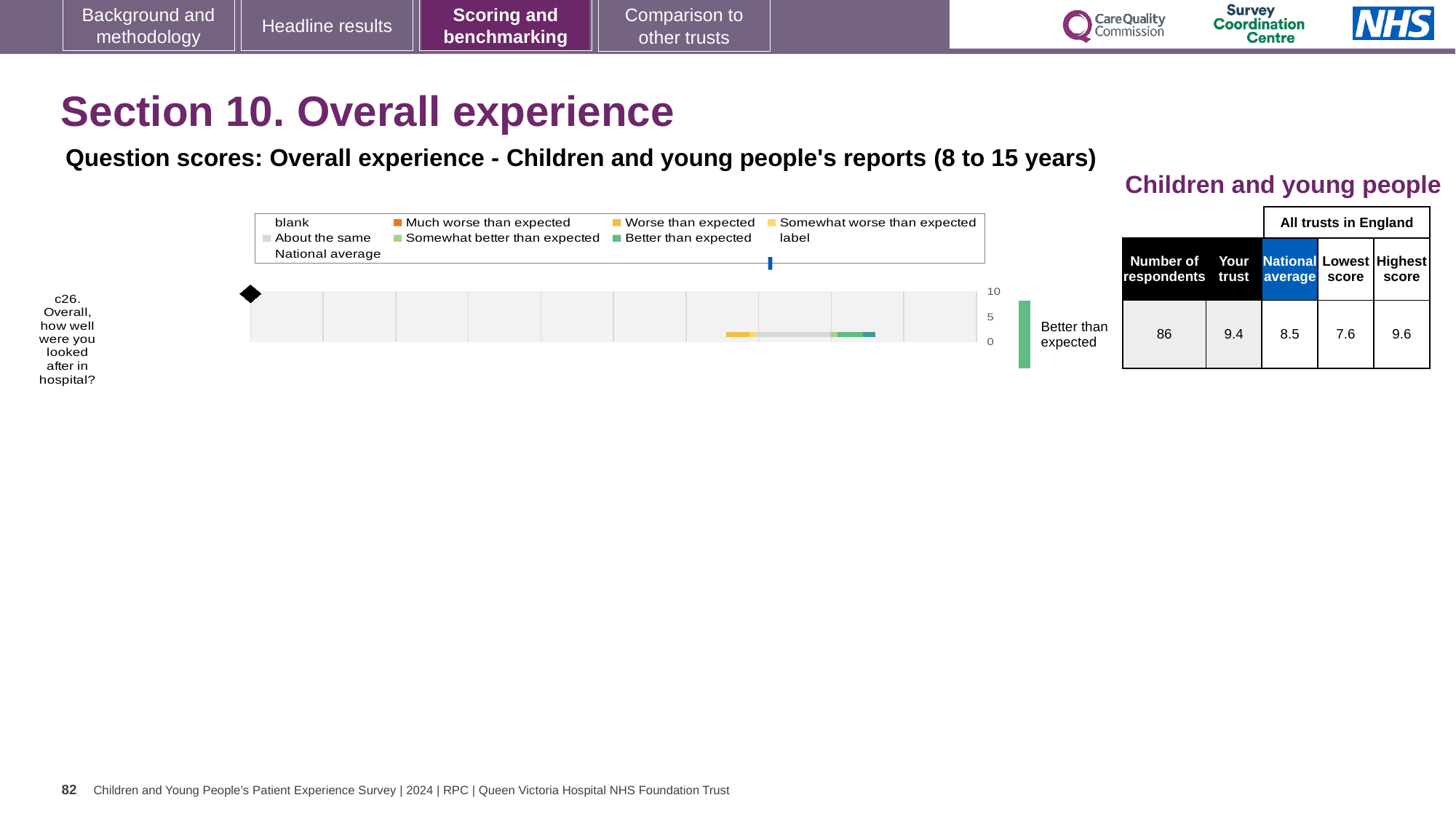
What is the difference between the 'Your trust' score and the national average for question c26? 0.9 Is the 'Your trust' score for question c26 greater or less than 5 on the chart's axis? greater What is the national average score for question c26? 8.5 What benchmarking category label is shown to the right of the chart for question c26? Better than expected What is the highest score among all trusts in England for question c26? 9.6 How many survey questions are plotted in the chart? 1 What is the 'Your trust' score for question c26? 9.4 What is the lowest score among all trusts in England for question c26? 7.6 How many respondents answered question c26? 86 What kind of chart is used to show the benchmarking result for question c26? bar chart Which is higher for question c26, the 'Your trust' score or the national average? Your trust What is the question label shown on the left of the chart? c26. Overall, how well were you looked after in hospital?